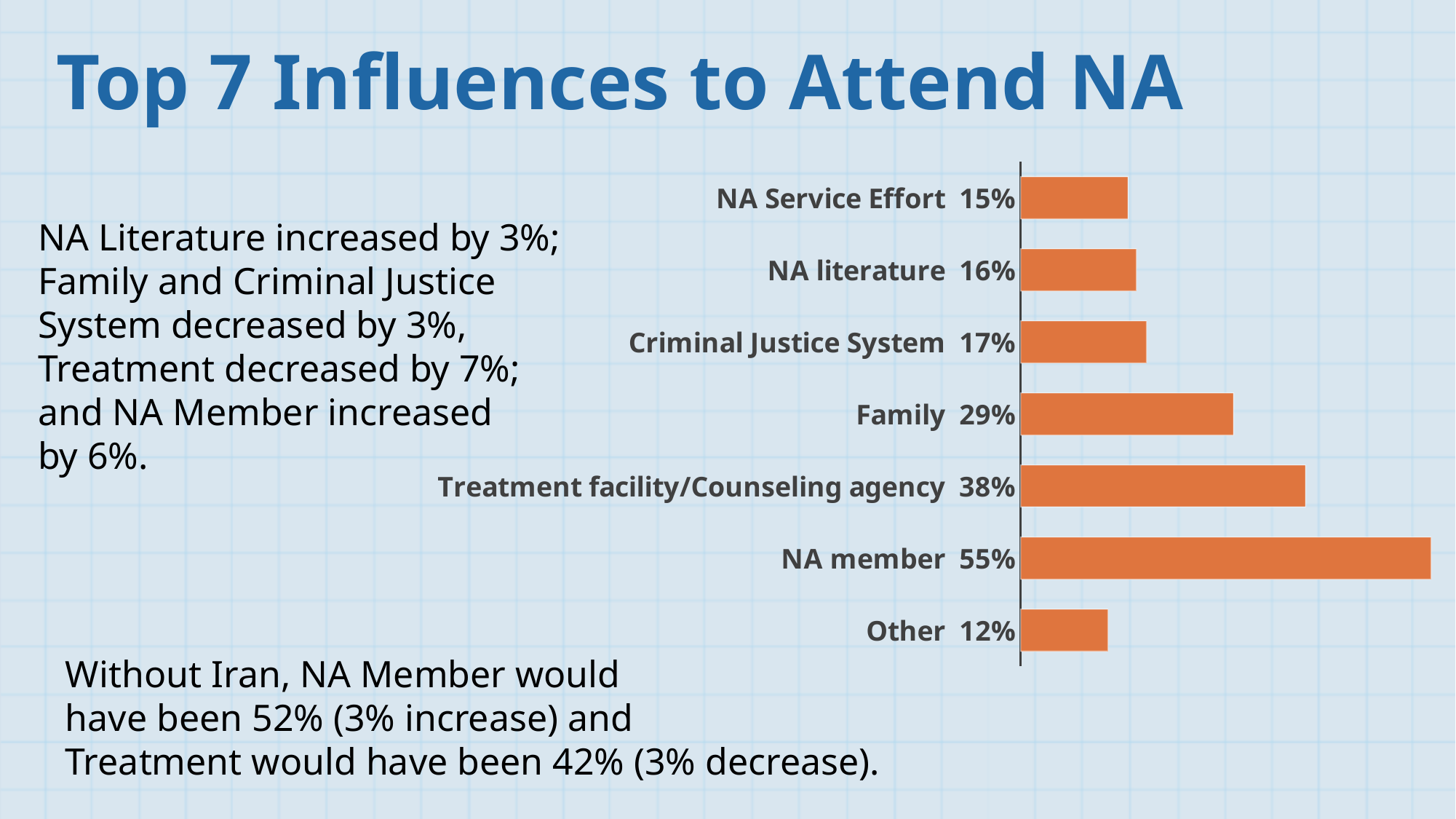
What is the difference between the values for Family and NA literature? 13% What percentage is shown for NA Service Effort? 15% What is the difference between the values for NA member and Treatment facility/Counseling agency? 17% What is the title of the slide? Top 7 Influences to Attend NA What percentage is shown for Family? 29% Which category has the highest value? NA member Which is larger, the value for Criminal Justice System or the value for NA Service Effort? Criminal Justice System What percentage is shown for Treatment facility/Counseling agency? 38% What kind of chart is shown on the slide? Bar chart What percentage is shown for NA member? 55% Which category has the lowest value? Other How many categories are shown in the chart? 7